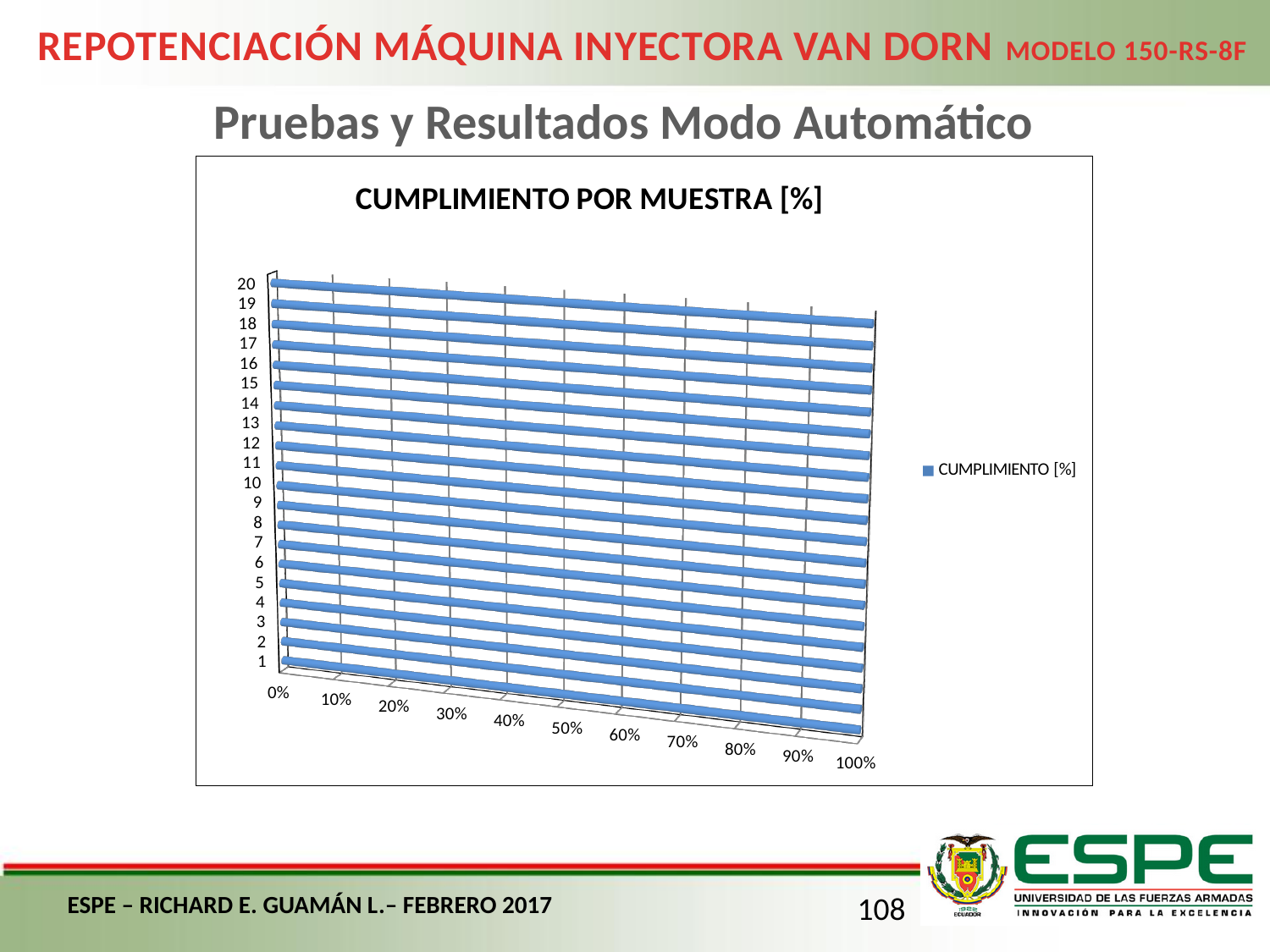
Do the values rise, fall, or stay the same across samples 1 to 20? stay the same What is the name of the series shown in the legend? CUMPLIMIENTO [%] What is the value for sample 5? 100% What is the highest value shown on the percentage axis? 100% Is the value for sample 10 greater or less than 80%? greater How many series does the legend list? 1 Is the value for sample 20 greater or less than 50%? greater Is the value for sample 1 greater or less than 90%? greater What kind of chart is shown on the slide? bar chart What is the title of the chart? CUMPLIMIENTO POR MUESTRA [%] What is the value for sample 15? 100% How many categories (samples) are plotted on the chart? 20